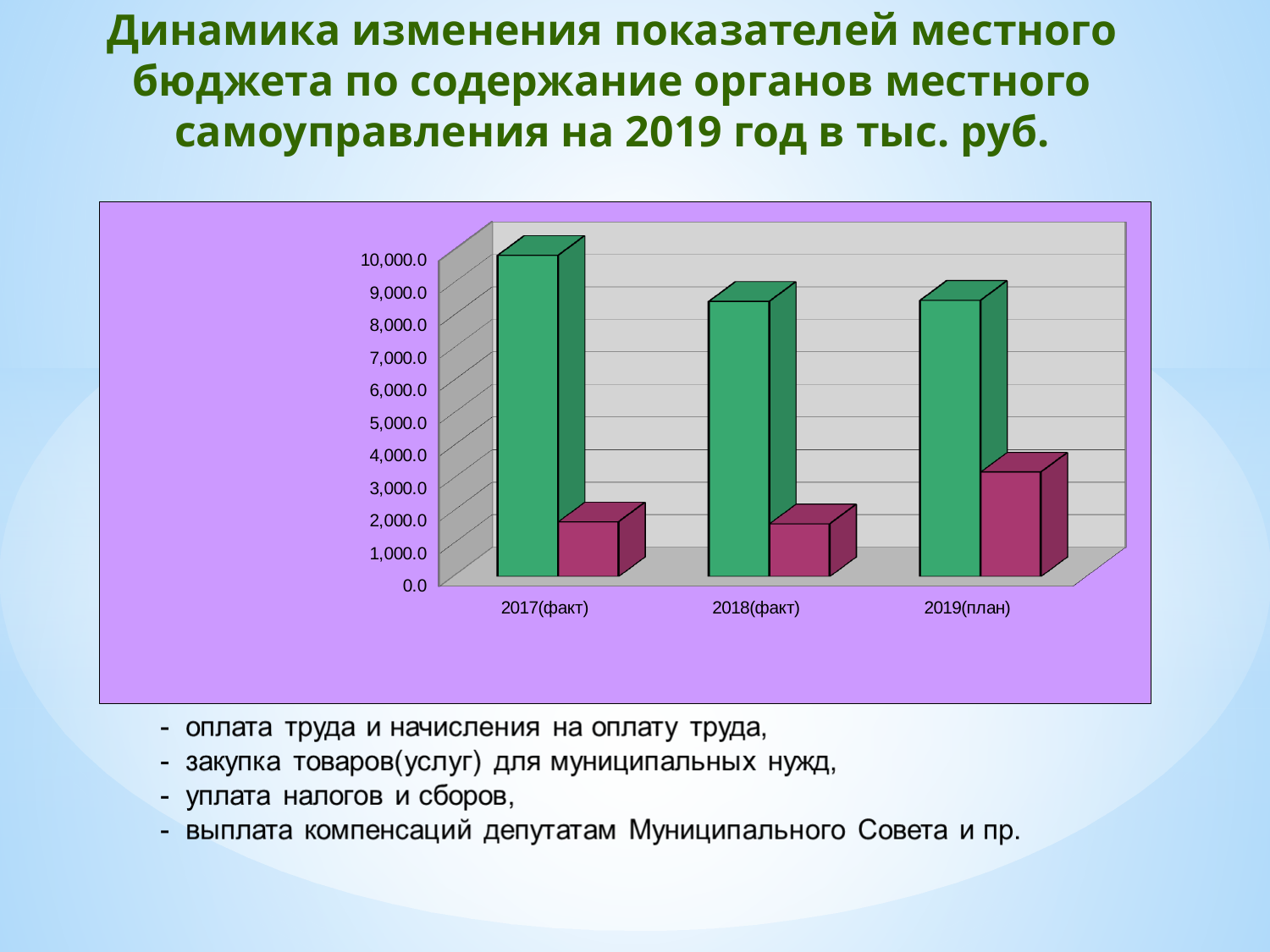
Is the pink bar for 2019(план) greater or less than 3,000.0? greater Which category has the tallest pink bar? 2019(план) Is the green bar for 2018(факт) greater or less than 8,000.0? greater How many categories are shown on the x axis of the chart? 3 Is the green bar for 2017(факт) greater or less than 9,000.0? greater How many bars are shown for each category in the chart? 2 What kind of chart is shown on the slide? bar chart Which category has the tallest green bar? 2017(факт) Which is larger, the green bar for 2017(факт) or the green bar for 2018(факт)? 2017(факт) Which is larger, the pink bar for 2019(план) or the pink bar for 2018(факт)? 2019(план)